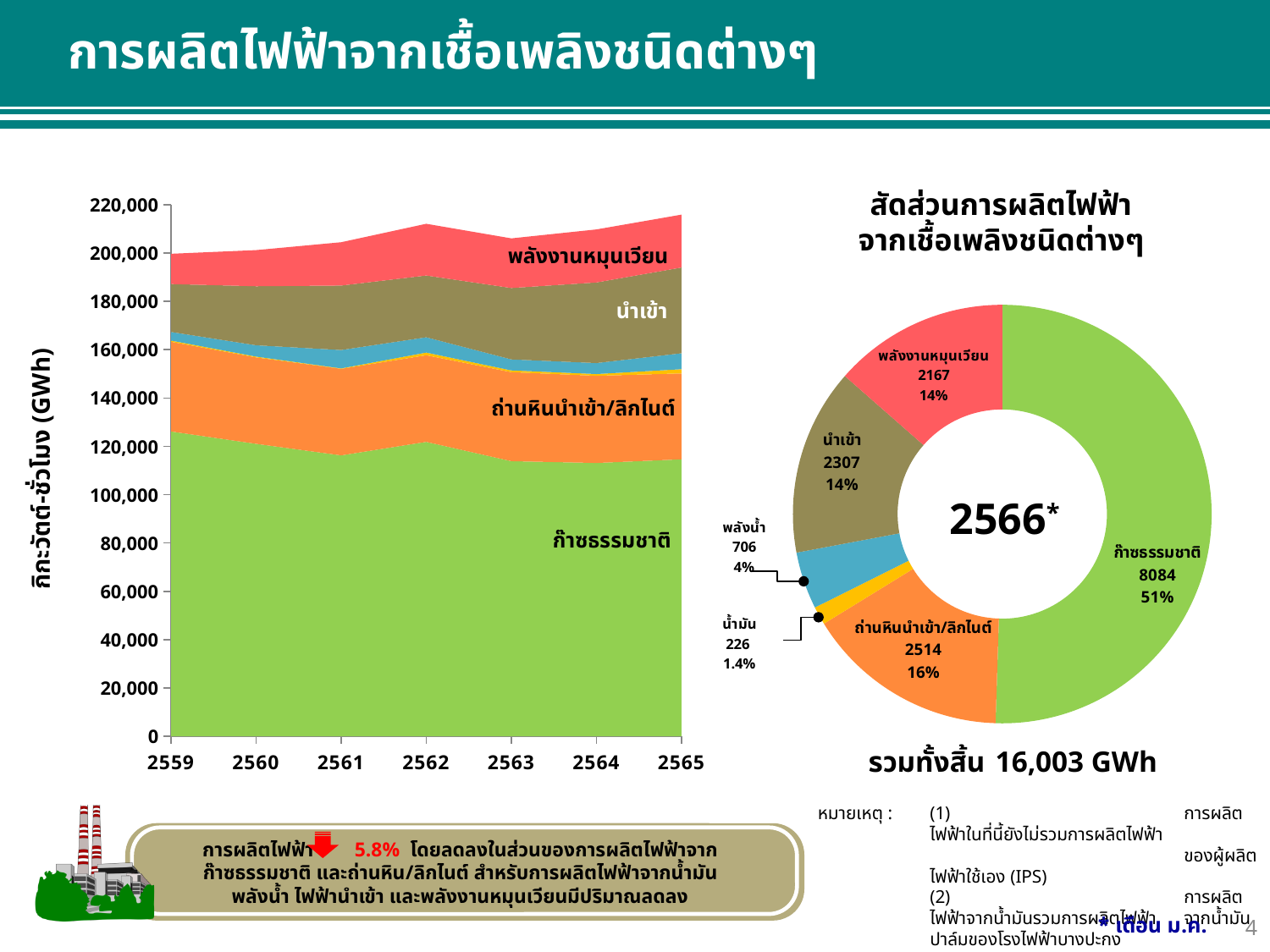
In the donut chart on the right, how many fuel categories are shown? 6 What kind of chart is the chart on the left of the slide? Stacked area chart In the donut chart on the right, which is larger, the value for พลังน้ำ or the value for น้ำมัน? พลังน้ำ In the area chart on the left, how many years are shown on the x axis? 7 In the donut chart on the right, which fuel type has the smallest share? น้ำมัน In the donut chart on the right, what is the difference between the values for นำเข้า and พลังงานหมุนเวียน? 140 In the donut chart on the right, which fuel type has the largest share? ก๊าซธรรมชาติ In the donut chart titled สัดส่วนการผลิตไฟฟ้าจากเชื้อเพลิงชนิดต่างๆ, what value is shown for ก๊าซธรรมชาติ? 8084 In the donut chart on the right, what percentage share does ถ่านหินนำเข้า/ลิกไนต์ have? 16% In the area chart on the left, is the total generation in 2565 greater or less than 200,000? greater In the donut chart on the right, what value is shown for น้ำมัน? 226 What total (รวมทั้งสิ้น) is stated below the donut chart on the right? 16,003 GWh